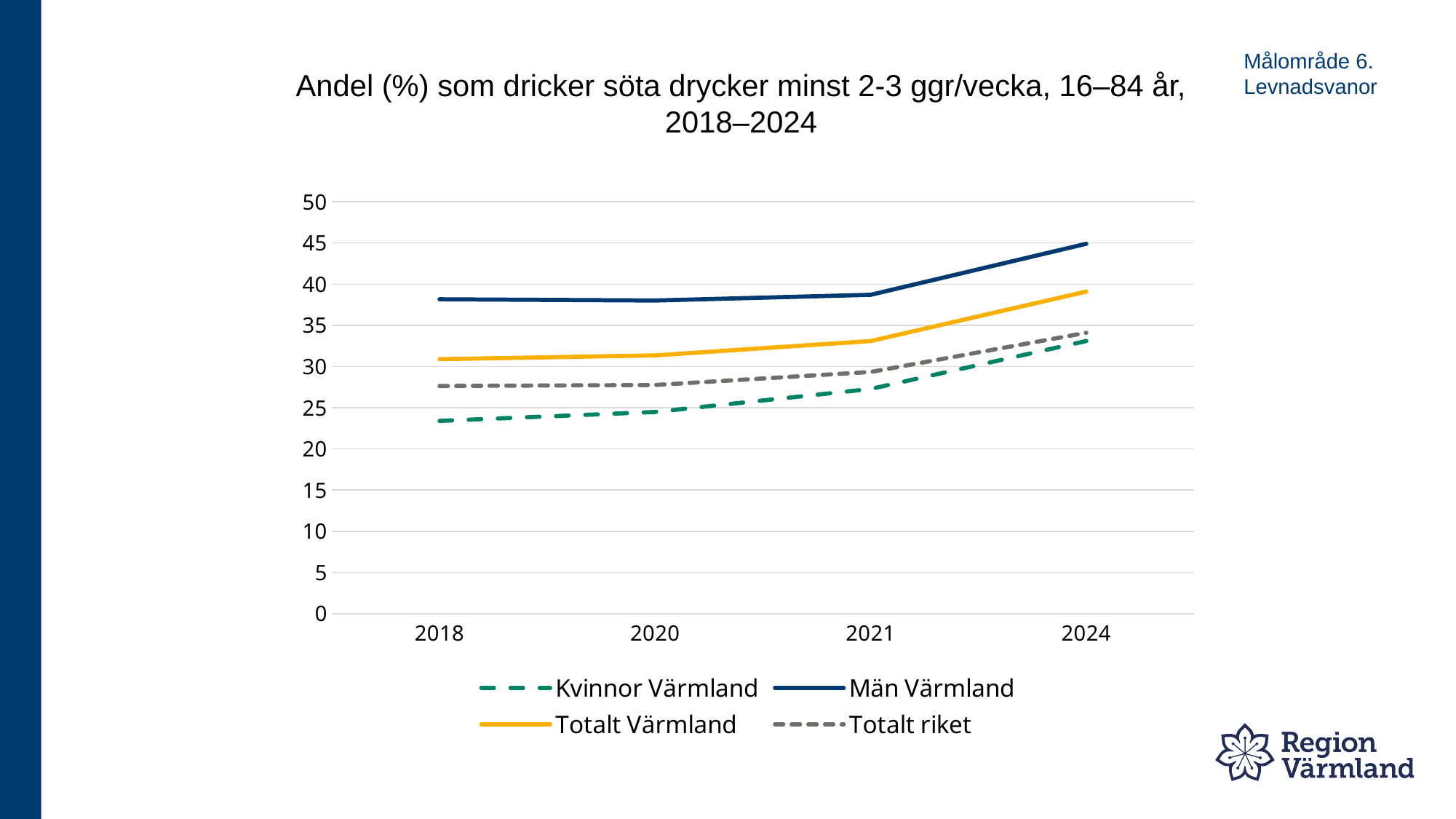
Which series has the highest value in 2024? Män Värmland How many years are shown on the x axis? 4 Is the value for Kvinnor Värmland in 2018 greater or less than 25? less Is the value for Totalt riket in 2018 greater or less than 30? less Is the value for Män Värmland in 2024 greater or less than 40? greater Which is larger in 2024, Totalt Värmland or Totalt riket? Totalt Värmland Which series is drawn with a solid yellow line? Totalt Värmland Which series has the lowest value in 2018? Kvinnor Värmland Does the value for Kvinnor Värmland rise or fall from 2018 to 2024? rise How many series does the legend list? 4 What kind of chart is shown on the slide? Line chart